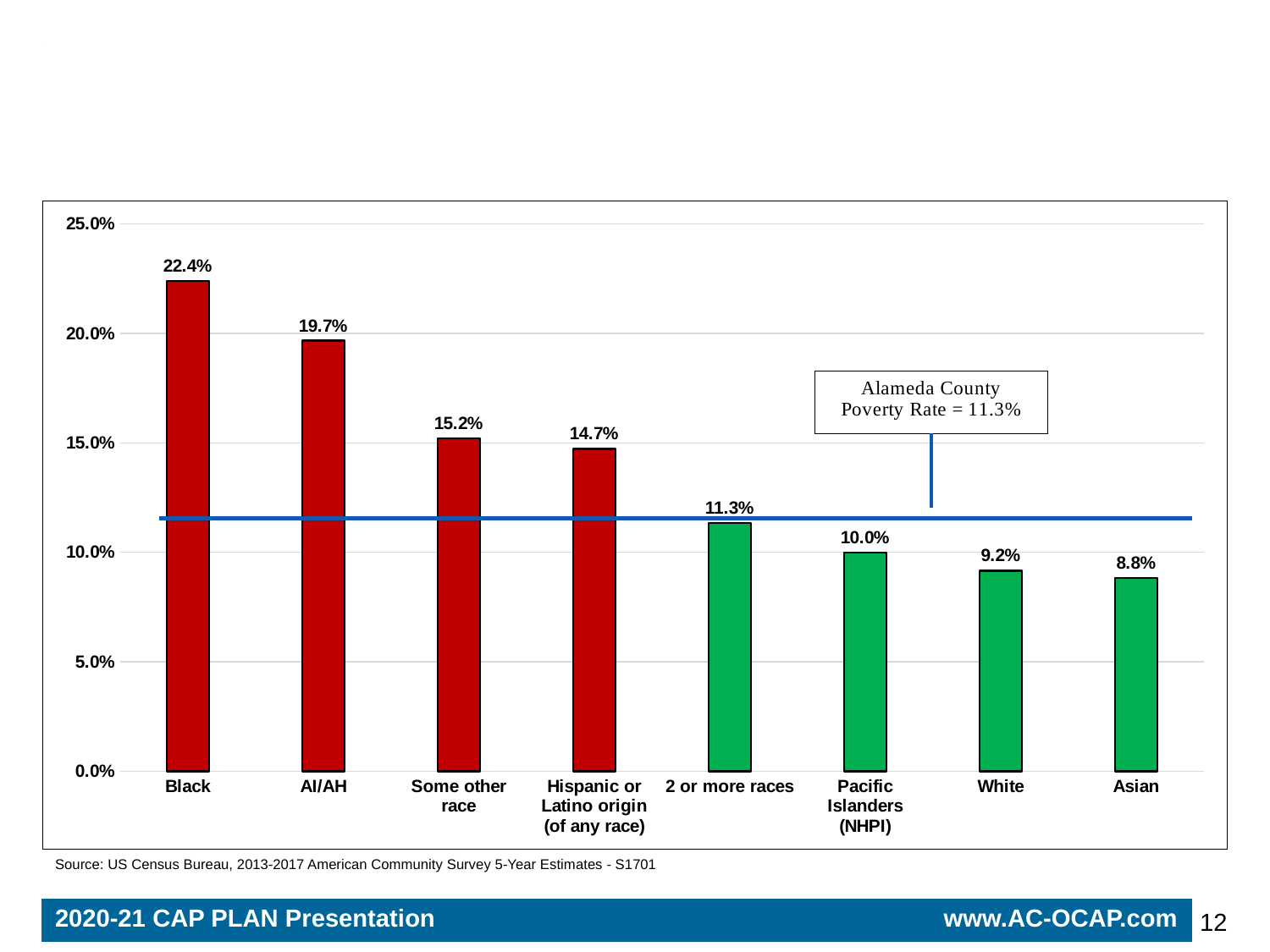
Which category has the lowest poverty rate? Asian What is the difference between the poverty rates for White and Asian? 0.4% Is the value for AI/AH greater or less than 20.0%? less What is the poverty rate shown for Hispanic or Latino origin (of any race)? 14.7% What kind of chart is shown on the slide? bar chart Which category has the highest poverty rate? Black What is the poverty rate shown for Pacific Islanders (NHPI)? 10.0% What Alameda County poverty rate does the horizontal line on the chart represent? 11.3% What is the poverty rate shown for Black? 22.4% Which has a higher poverty rate, Some other race or 2 or more races? Some other race How many categories are shown on the x axis? 8 What is the difference between the poverty rates for Black and AI/AH? 2.7%